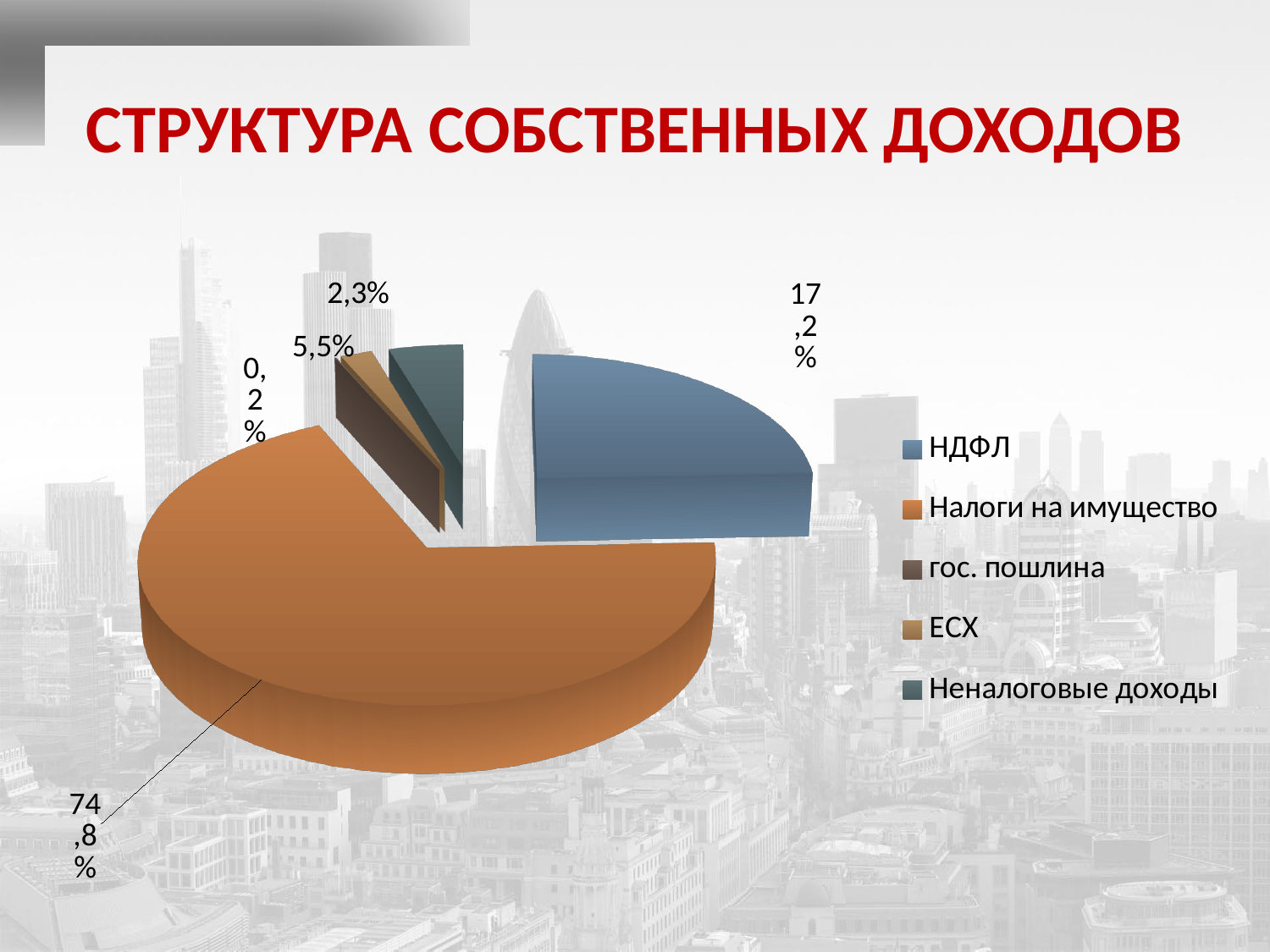
Which category has the largest slice of the pie? Налоги на имущество How many categories does the legend of the pie chart list? 5 Which is larger, the share of ЕСХ or the share of Неналоговые доходы? ЕСХ What share of the pie does Неналоговые доходы have? 2,3% What colour is the slice for НДФЛ? Blue What is the title of the chart on the slide? СТРУКТУРА СОБСТВЕННЫХ ДОХОДОВ Which category has the smallest slice of the pie? гос. пошлина What share of the pie does НДФЛ have? 17,2% What kind of chart is shown on the slide? Pie chart What share of the pie does ЕСХ have? 5,5% What is the difference between the shares of Налоги на имущество and НДФЛ? 57,6%